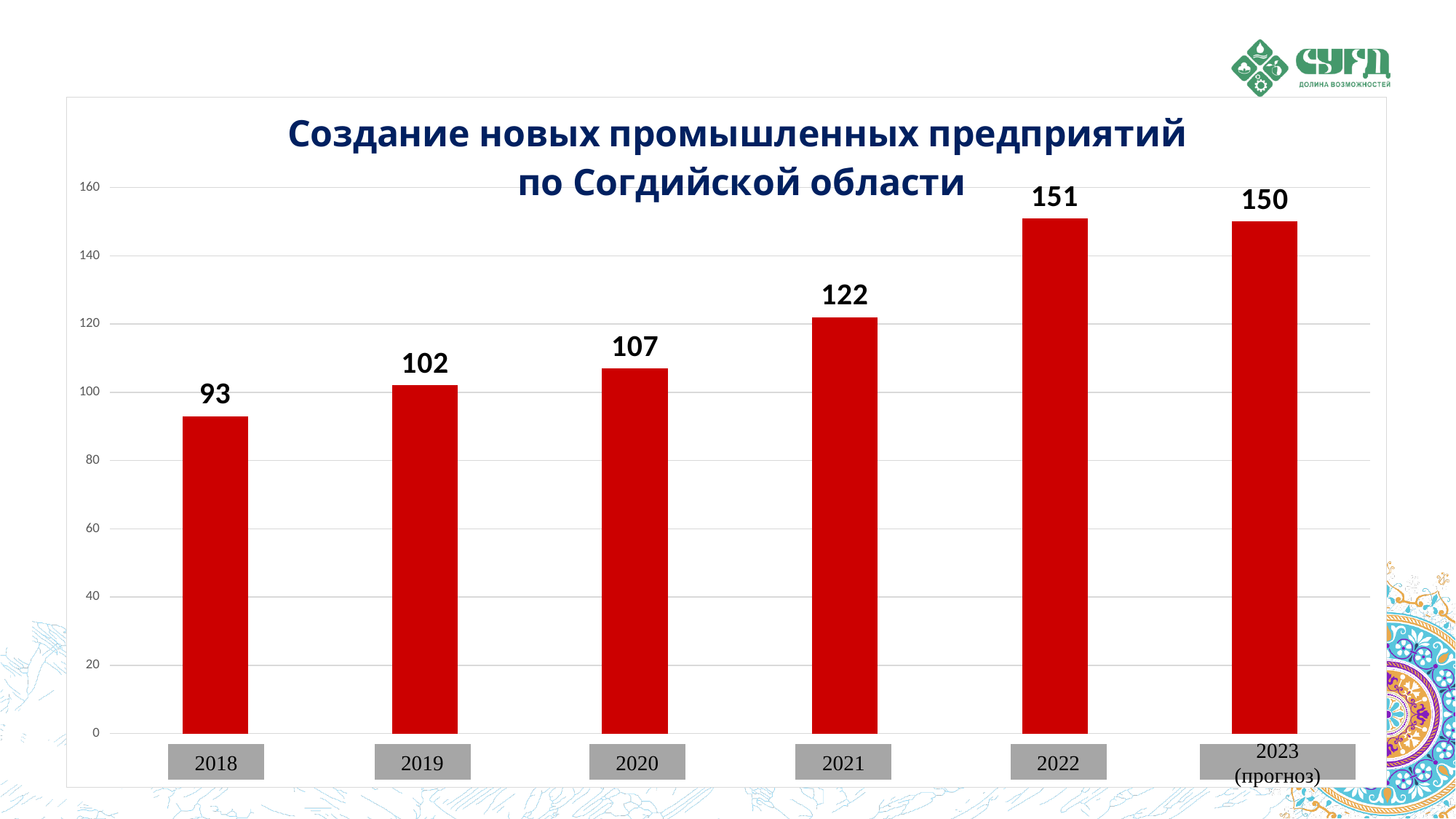
How many years are shown on the x axis? 6 What is the difference between the values for 2022 and 2018? 58 What is the value for 2021? 122 What is the value for 2023 (прогноз)? 150 What is the value for 2018? 93 Which year has the highest value? 2022 Which is larger, the value for 2021 or the value for 2020? 2021 Is the value for 2019 greater or less than 120? less What is the title of the chart? Создание новых промышленных предприятий по Согдийской области What is the difference between the values for 2020 and 2019? 5 What kind of chart is shown on the slide? bar chart Which year has the lowest value? 2018